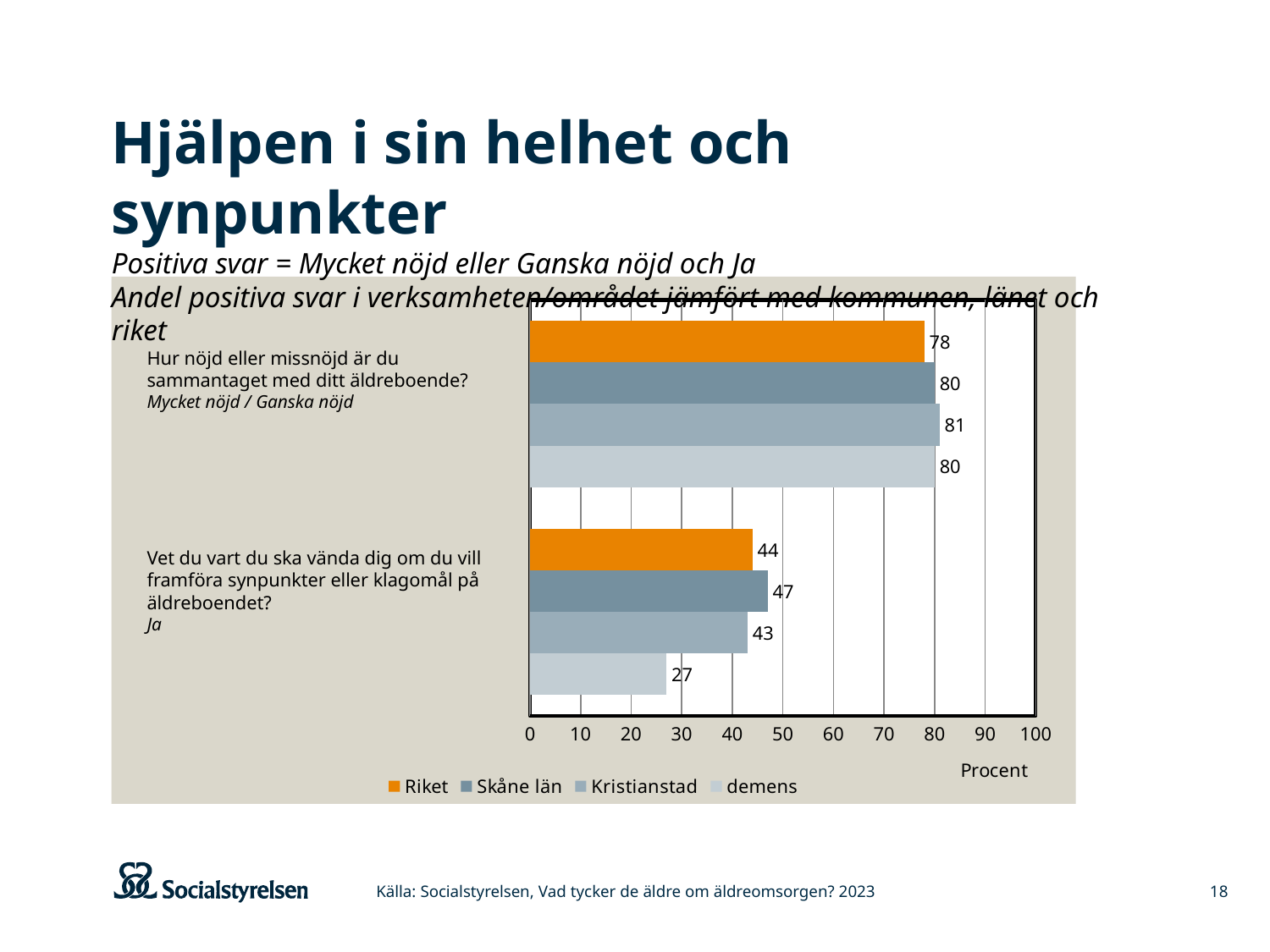
How many series does the legend list? 4 What label is shown on the horizontal axis of the chart? Procent Which is larger on the question "Hur nöjd eller missnöjd är du sammantaget med ditt äldreboende?": the value for Riket or the value for Kristianstad? Kristianstad What is the value for Riket on the question "Hur nöjd eller missnöjd är du sammantaget med ditt äldreboende?"? 78 What kind of chart is shown on the slide? bar chart Which series has the highest value on the question "Vet du vart du ska vända dig om du vill framföra synpunkter eller klagomål på äldreboendet?"? Skåne län Which series has the lowest value on the question "Vet du vart du ska vända dig om du vill framföra synpunkter eller klagomål på äldreboendet?"? demens What is the difference between the Kristianstad value and the demens value on the question "Vet du vart du ska vända dig om du vill framföra synpunkter eller klagomål på äldreboendet?"? 16 What is the value for demens on the question "Vet du vart du ska vända dig om du vill framföra synpunkter eller klagomål på äldreboendet?"? 27 Is the value for Riket on the question "Vet du vart du ska vända dig om du vill framföra synpunkter eller klagomål på äldreboendet?" greater or less than 50? less What is the value for Kristianstad on the question "Hur nöjd eller missnöjd är du sammantaget med ditt äldreboende?"? 81 What is the value for Skåne län on the question "Vet du vart du ska vända dig om du vill framföra synpunkter eller klagomål på äldreboendet?"? 47